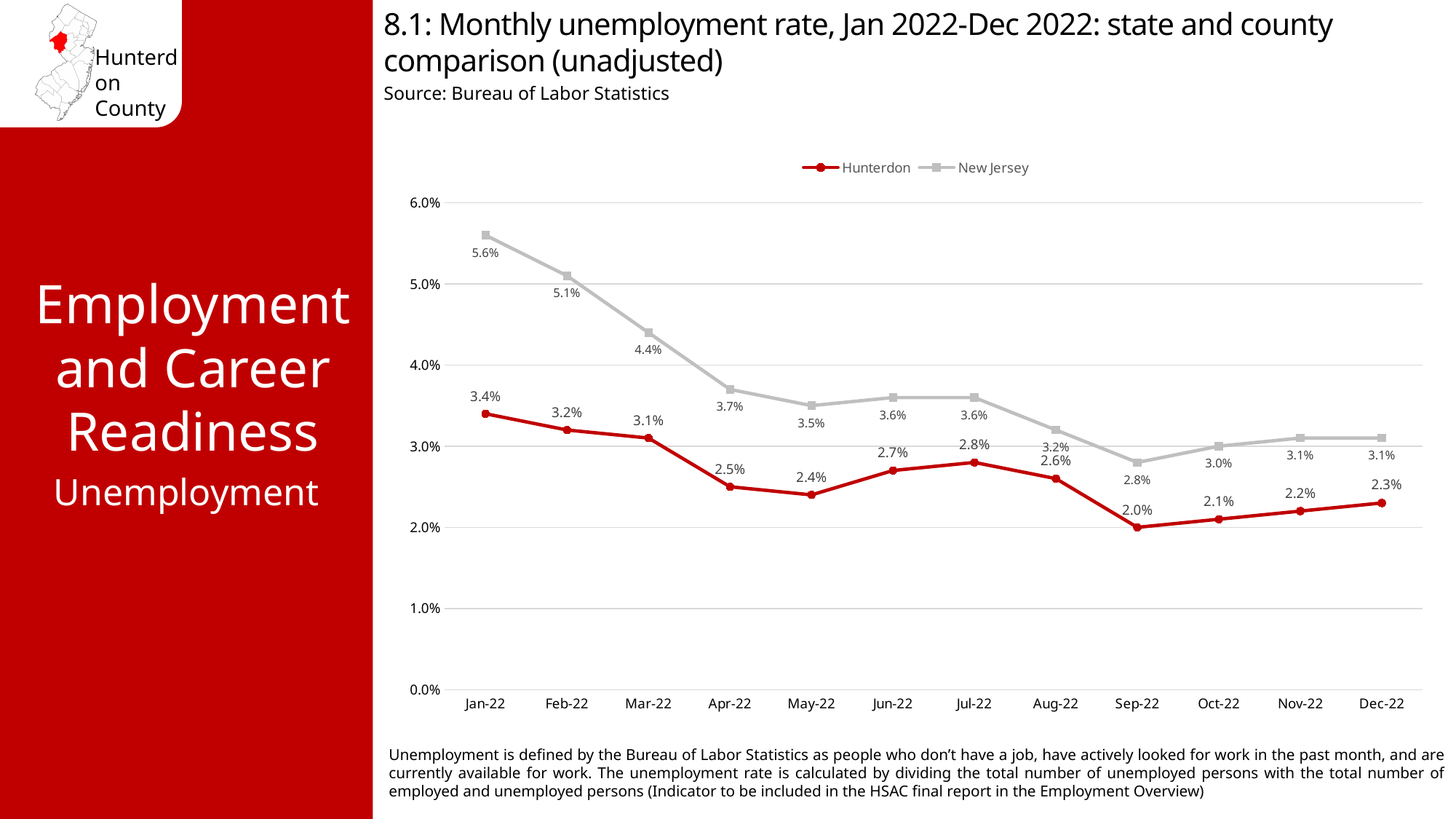
Which series had the higher unemployment rate in Dec-22, Hunterdon or New Jersey? New Jersey What kind of chart is shown on the slide? Line chart Did the New Jersey unemployment rate rise or fall from Jan-22 to May-22? Fall How many months are plotted on the x axis? 12 What was the New Jersey unemployment rate in Mar-22? 4.4% What was the Hunterdon unemployment rate in Sep-22? 2.0% In which month was the Hunterdon unemployment rate lowest? Sep-22 In which month was the New Jersey unemployment rate highest? Jan-22 What was the Hunterdon unemployment rate in Jan-22? 3.4% How many series does the legend list? 2 What is the difference between the New Jersey and Hunterdon unemployment rates in Jan-22? 2.2% What is the source cited for the chart? Bureau of Labor Statistics